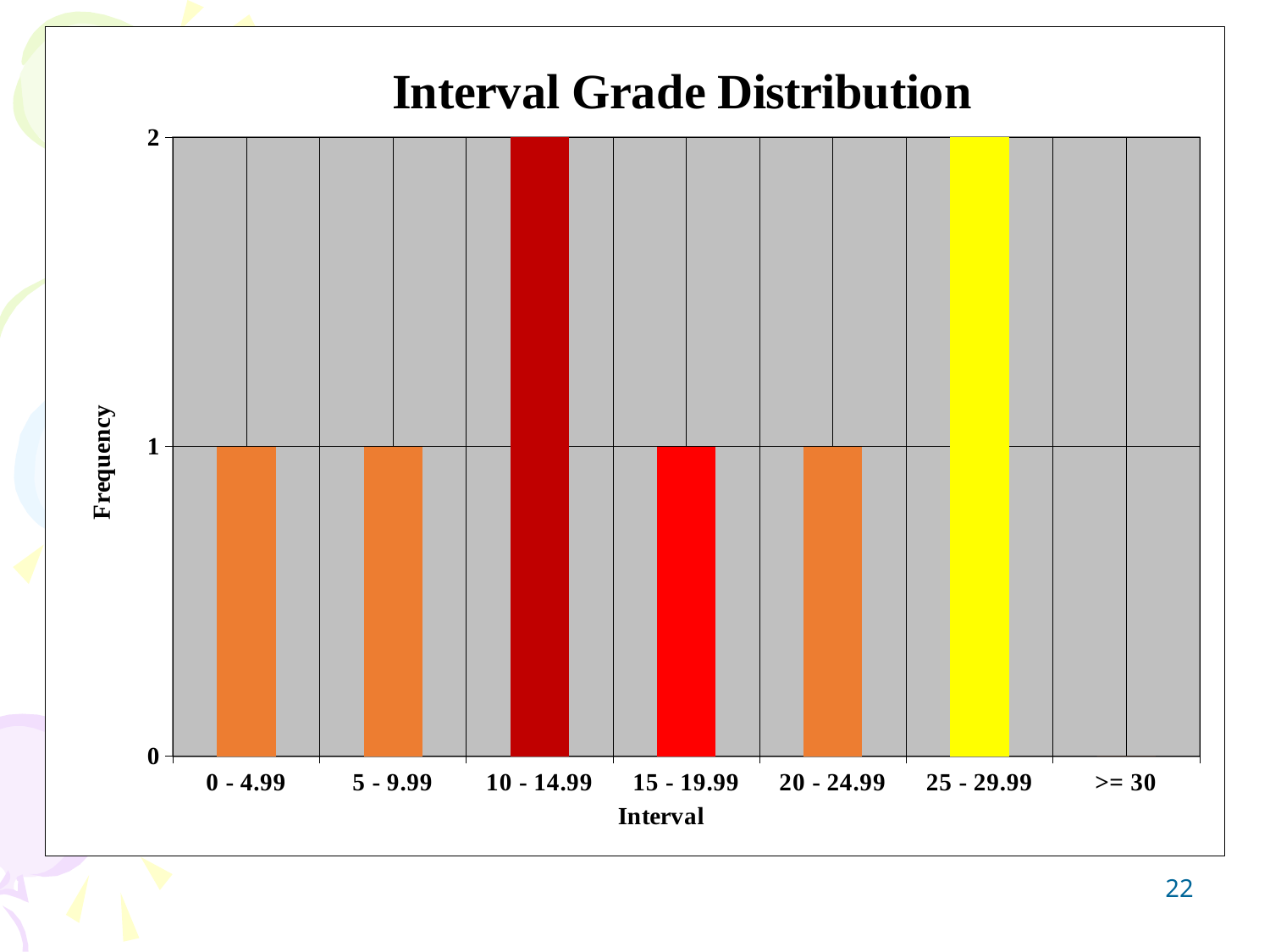
Which has a higher frequency, the 25 - 29.99 interval or the 20 - 24.99 interval? 25 - 29.99 Which interval has the lowest frequency? >= 30 What is the frequency for the 0 - 4.99 interval? 1 What is the label of the y axis? Frequency What kind of chart is shown on the slide? Bar chart What is the frequency for the >= 30 interval? 0 What is the title of the chart? Interval Grade Distribution What is the difference in frequency between the 10 - 14.99 interval and the 15 - 19.99 interval? 1 What is the frequency for the 25 - 29.99 interval? 2 What is the frequency for the 10 - 14.99 interval? 2 How many intervals are shown on the x axis? 7 Which intervals have the highest frequency? 10 - 14.99 and 25 - 29.99